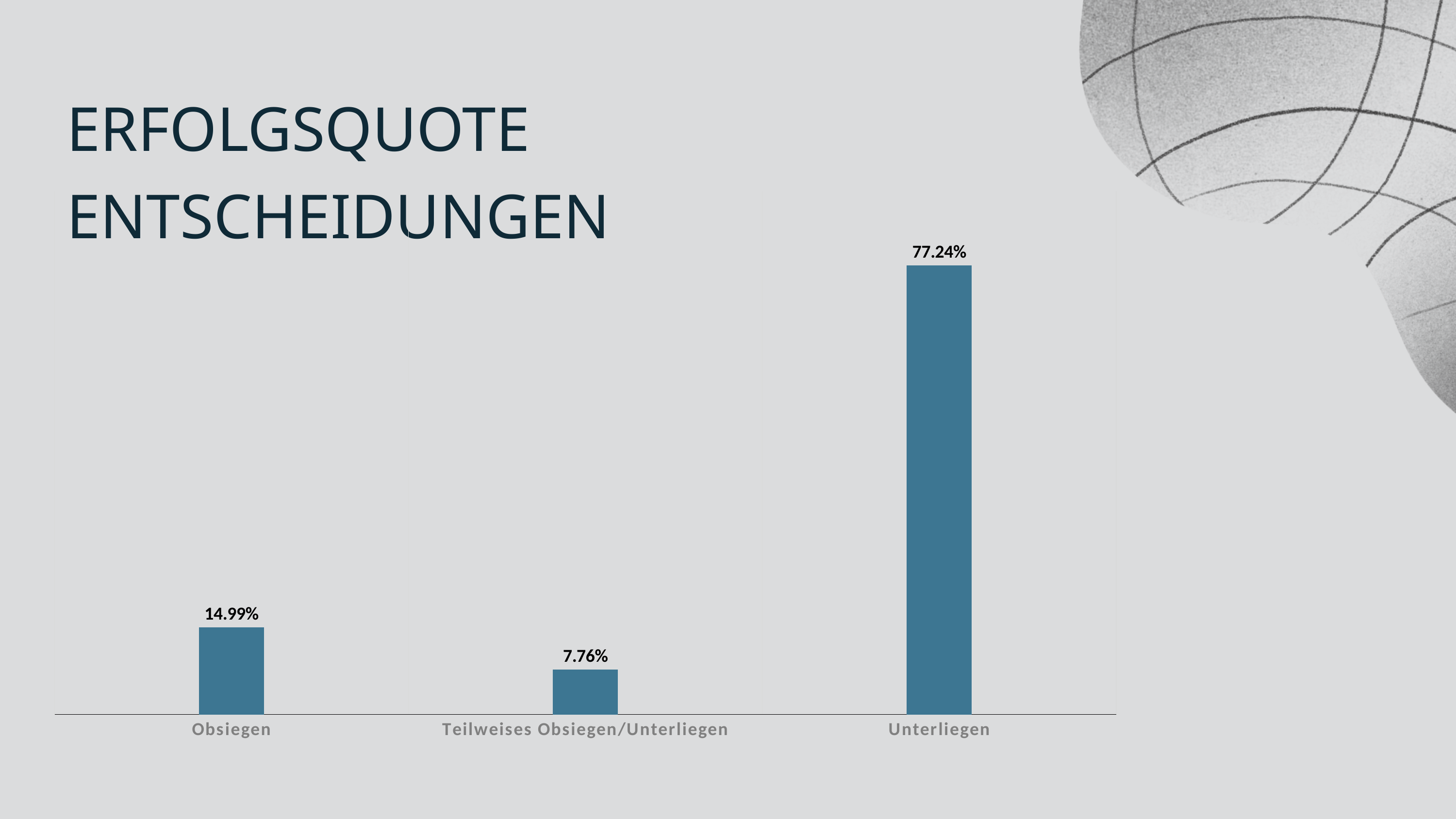
What is the difference between the values for Unterliegen and Obsiegen? 62.25% What colour are the bars in the chart? Blue What is the value for Obsiegen? 14.99% What is the difference between the values for Obsiegen and Teilweises Obsiegen/Unterliegen? 7.23% Which category has the lowest value? Teilweises Obsiegen/Unterliegen Which is larger, the value for Obsiegen or the value for Teilweises Obsiegen/Unterliegen? Obsiegen How many categories are shown in the chart? 3 What is the value for Teilweises Obsiegen/Unterliegen? 7.76% What kind of chart is shown on the slide? Bar chart What is the value for Unterliegen? 77.24% Which category has the highest value? Unterliegen What is the title of the slide? Erfolgsquote Entscheidungen